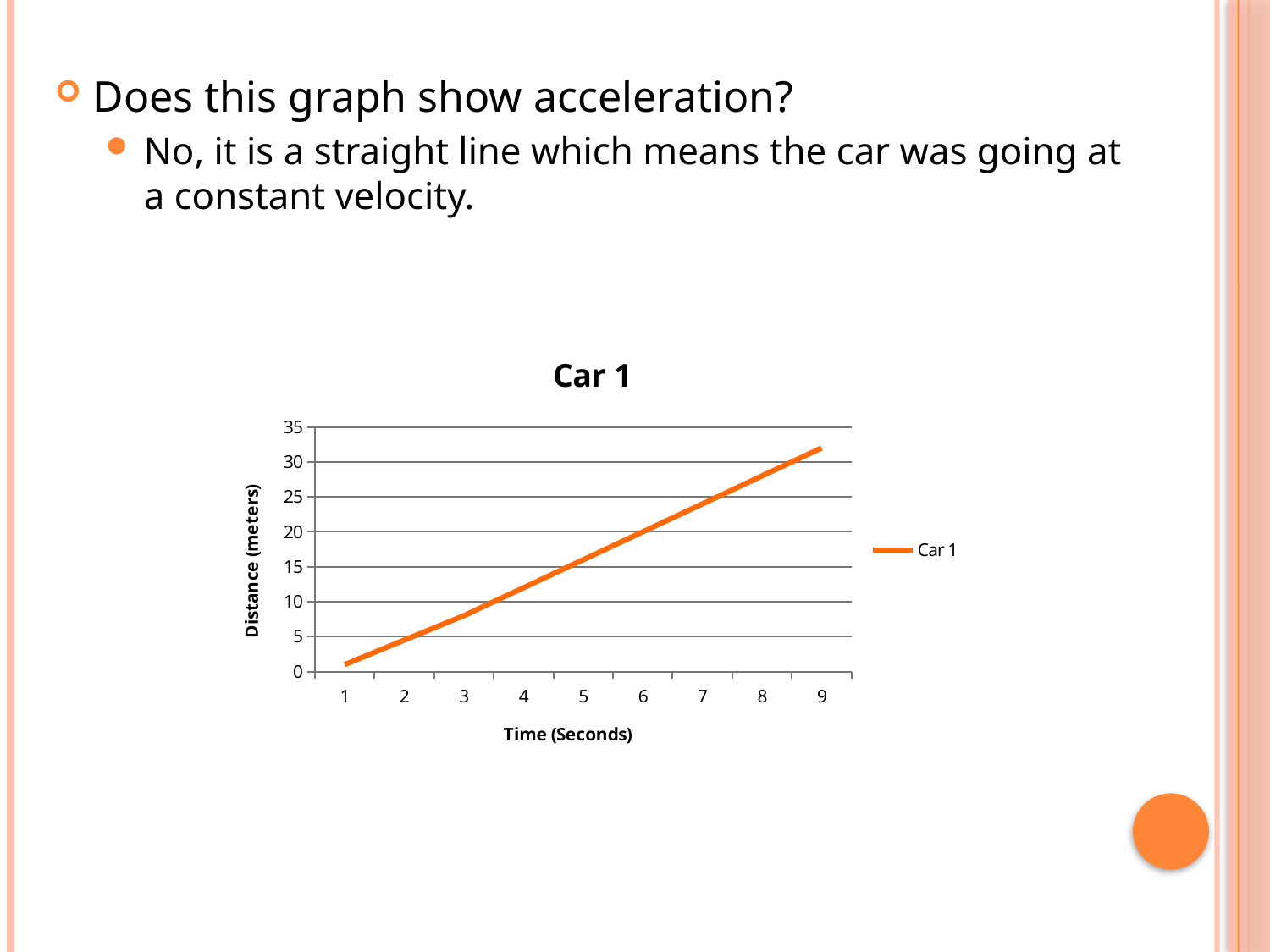
At which time (in seconds) is the distance highest? 9 Is the distance at 3 seconds greater or less than 10? less How many series does the legend list? 1 Is the distance at 8 seconds greater or less than 25? greater At which time (in seconds) is the distance lowest? 1 Does the distance rise or fall as time increases along the x axis? rise What is the label of the y axis? Distance (meters) Is the distance at 9 seconds greater or less than 30? greater How many time points are plotted along the x axis? 9 What kind of chart is shown on the slide? line chart What is the title of the chart? Car 1